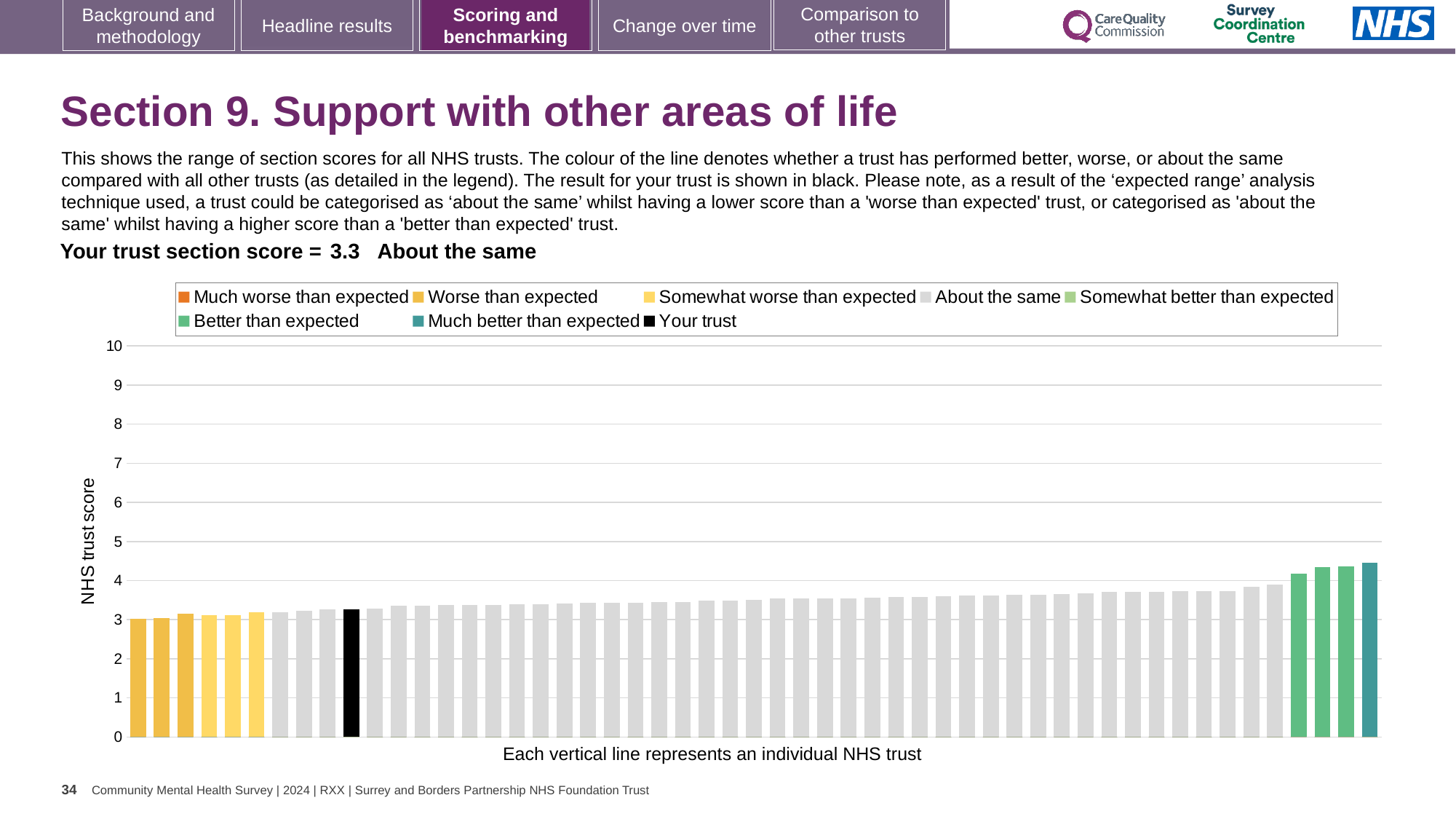
What is the label on the vertical axis of the chart? NHS trust score What is the section score for your trust shown on the slide? 3.3 What is the highest value shown on the vertical axis of the chart? 10 Do the bar values rise or fall from left to right across the chart? rise What colour is the bar representing your trust in the chart? black Is your trust's score (the black bar) greater or less than 3? greater Is the value of the shortest bar in the chart greater or less than 4? less How is your trust's section score categorised compared with other trusts? About the same How many entries does the chart legend list? 8 Is the value of the tallest bar in the chart greater or less than 4? greater What kind of chart is shown on the slide? bar chart